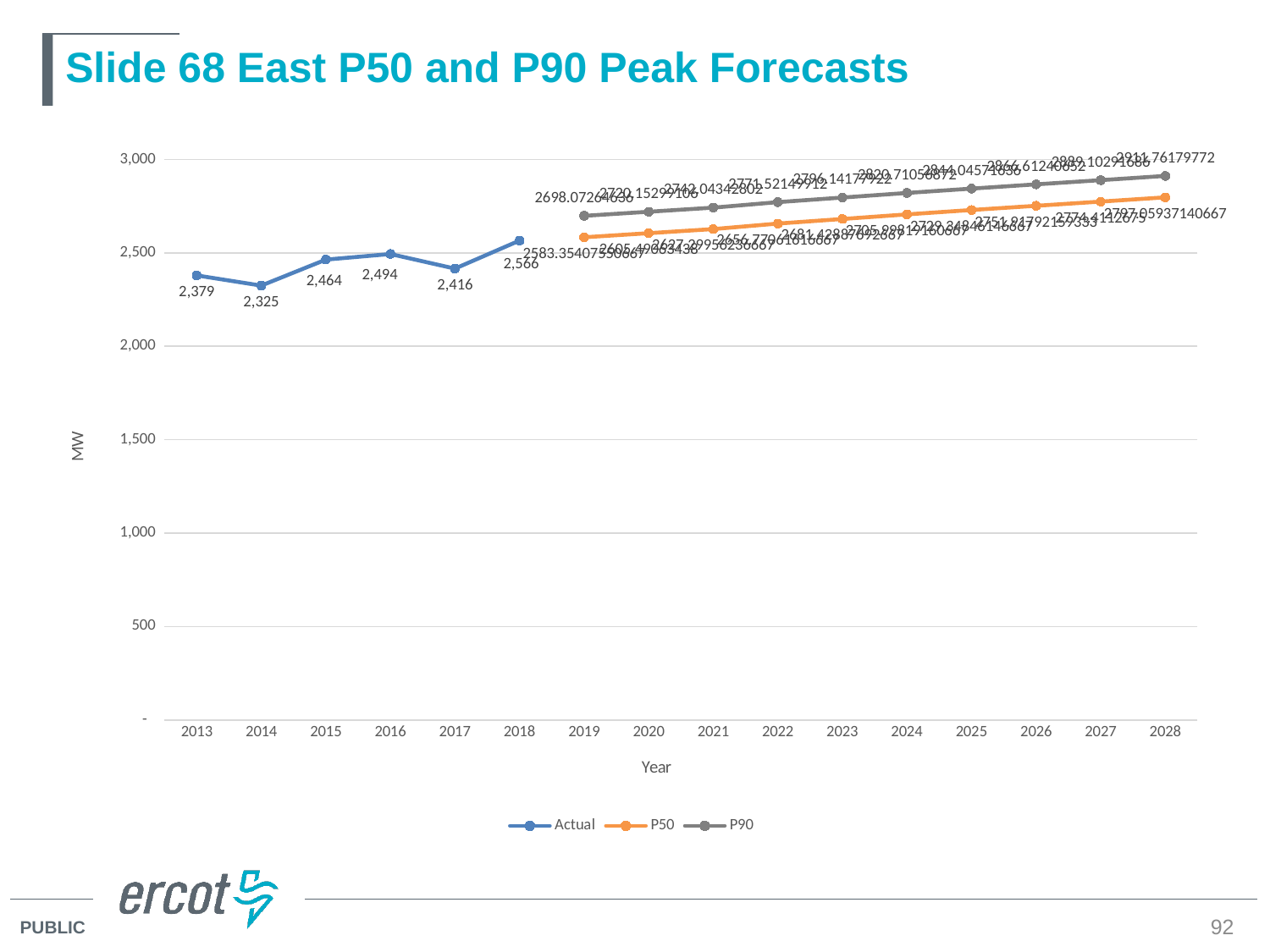
Which is larger, the Actual value for 2015 or for 2017? 2015 How many years are shown on the x axis? 16 What is the Actual value for 2018? 2,566 How many series does the legend list? 3 Do the P50 values rise or fall from 2019 to 2028? Rise What is the difference between the Actual values for 2018 and 2014? 241 Is the P90 value for 2028 greater or less than 2,500? greater What is the Actual value for 2016? 2,494 What is the Actual value for 2013? 2,379 Which year has the highest Actual value? 2018 Which year has the lowest Actual value? 2014 What type of chart is shown on the slide? Line chart